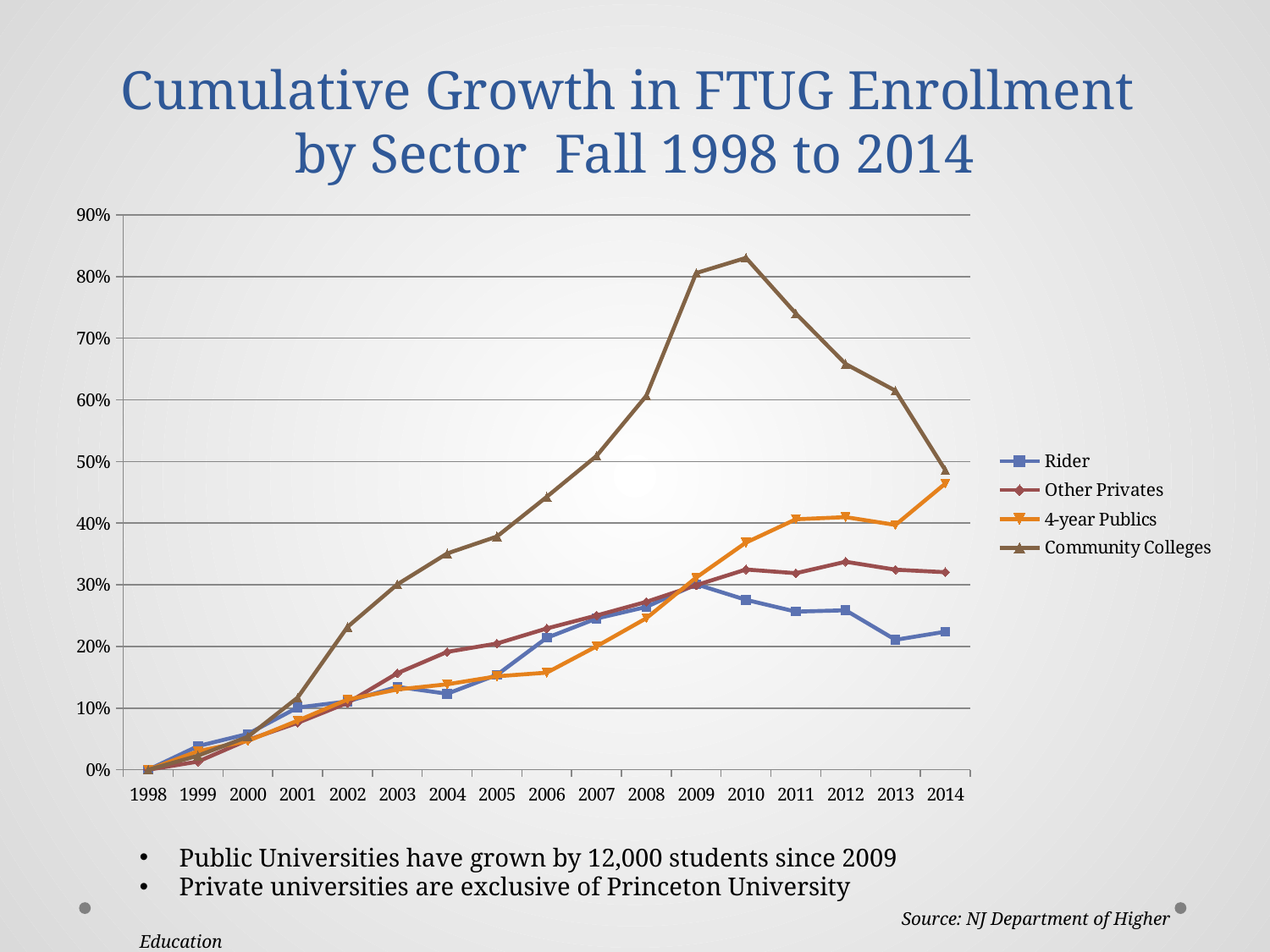
Which sector has the highest cumulative growth in 2010? Community Colleges Is the value for Community Colleges in 2010 greater or less than 80%? greater How many series does the legend list? 4 What kind of chart is shown on the slide? line chart Is the value for Rider in 2013 greater or less than 30%? less Which sector has the lowest cumulative growth in 2014? Rider Is the value for 4-year Publics in 2014 greater or less than 40%? greater How many years are plotted along the x axis? 17 What is the cumulative growth value for Rider in 1998? 0% Does the Community Colleges line rise or fall from 2010 to 2014? fall In 2014, which is larger: the value for 4-year Publics or the value for Other Privates? 4-year Publics Which series is drawn in orange? 4-year Publics